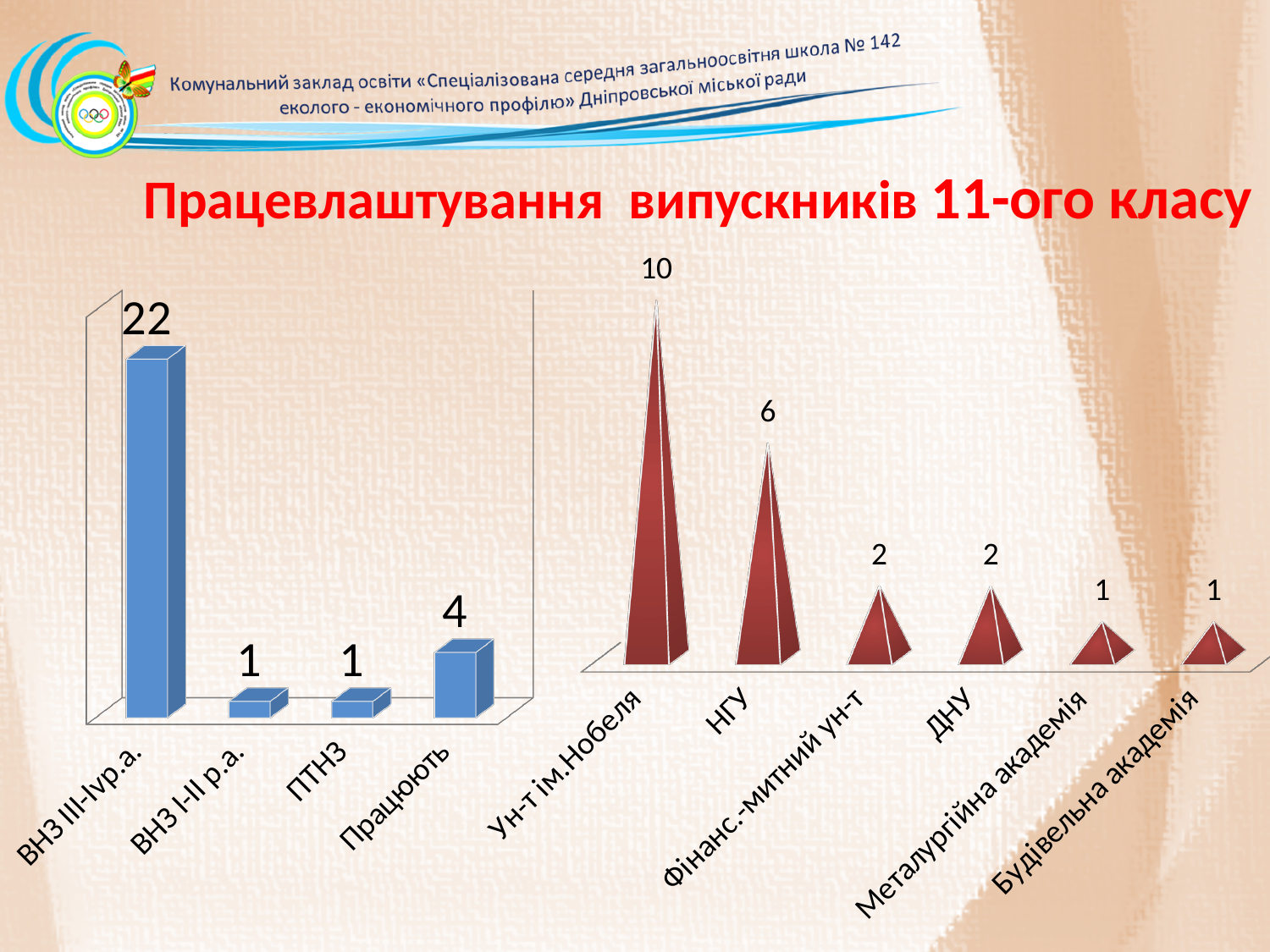
In the left chart, what is the value for ВНЗ III-IVр.а.? 22 In the right chart, what is the value for Ун-т ім.Нобеля? 10 In the right chart, which is larger, the value for НГУ or the value for Фінанс.-митний ун-т? НГУ In the right chart, how many categories are shown? 6 In the left chart, how many categories are shown? 4 In the right chart, which category has the highest value? Ун-т ім.Нобеля In the right chart, what is the value for НГУ? 6 In the left chart, what is the difference between the values for ВНЗ III-IVр.а. and Працюють? 18 In the left chart, what is the value for Працюють? 4 In the left chart, which category has the highest value? ВНЗ III-IVр.а. What kind of chart is the left chart? bar chart In the right chart, what is the value for ДНУ? 2